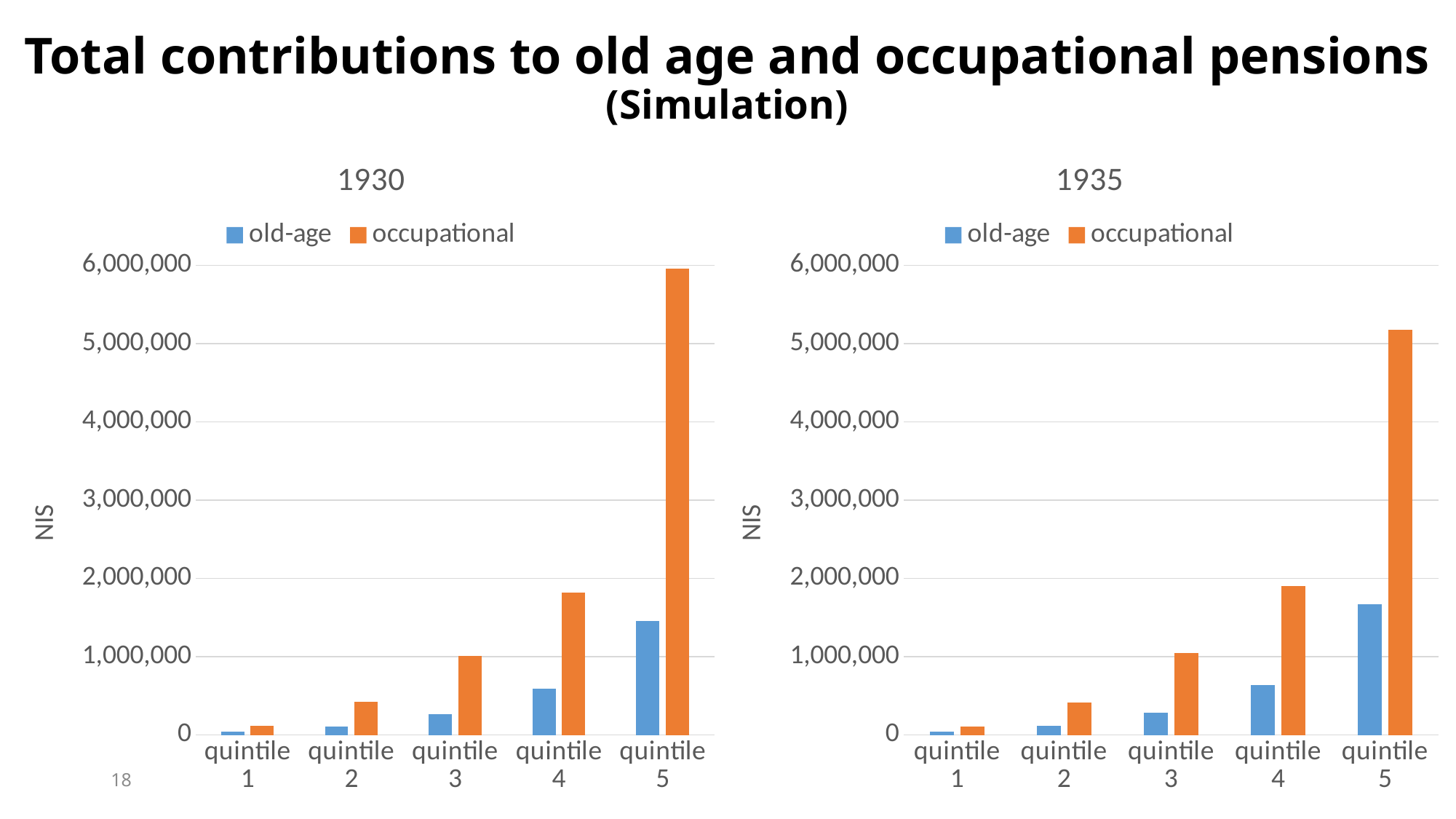
In the 1930 chart, which quintile has the highest occupational contribution? quintile 5 What kind of chart is the 1930 chart? bar chart In the 1930 chart, is the occupational value for quintile 5 greater or less than 5,000,000? greater What label is shown on the vertical axis of the 1935 chart? NIS How many quintile categories are shown on the x axis of the 1930 chart? 5 In the 1935 chart, which is larger for quintile 5: the old-age value or the occupational value? occupational In the 1930 chart, is the old-age value for quintile 5 greater or less than 2,000,000? less In the 1935 chart, is the old-age value for quintile 5 greater or less than 1,000,000? greater In the 1930 chart, do the occupational values rise or fall from quintile 1 to quintile 5? rise In the 1935 chart, which quintile has the lowest old-age contribution? quintile 1 How many series does the legend of the 1935 chart list? 2